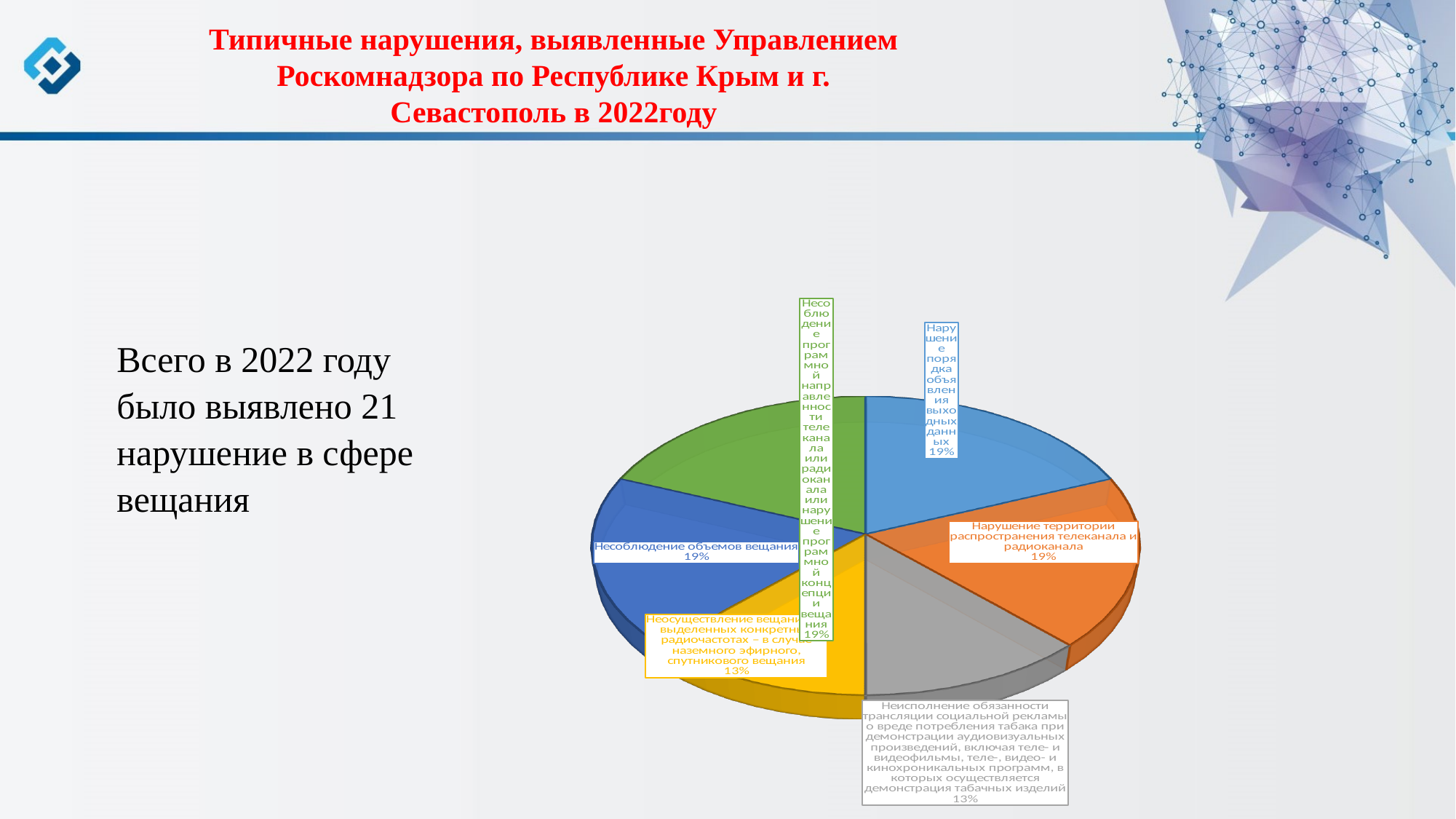
What share of the pie is labelled for "Неосуществление вещания на выделенных конкретных радиочастотах – в случае наземного эфирного, спутникового вещания"? 13% How many slices of the pie chart are labelled 13%? 2 What kind of chart is shown on the slide? pie chart What share of the pie is labelled for "Нарушение территории распространения телеканала и радиоканала"? 19% What colour is the slice labelled "Несоблюдение объемов вещания"? dark blue Which slice is larger: "Несоблюдение объемов вещания" or "Неосуществление вещания на выделенных конкретных радиочастотах"? Несоблюдение объемов вещания According to the text on the slide, how many violations in the broadcasting sphere were identified in total in 2022? 21 What share of the pie is labelled for "Несоблюдение объемов вещания"? 19% What is the difference in percentage points between the "Нарушение порядка объявления выходных данных" slice and the "Неосуществление вещания на выделенных конкретных радиочастотах" slice? 6 percentage points How many slices does the pie chart have? 6 What share of the pie is labelled for "Нарушение порядка объявления выходных данных"? 19% What share of the pie is labelled for the slice about failing to broadcast social advertising on the harm of tobacco consumption ("Неисполнение обязанности трансляции социальной рекламы о вреде потребления табака...")? 13%